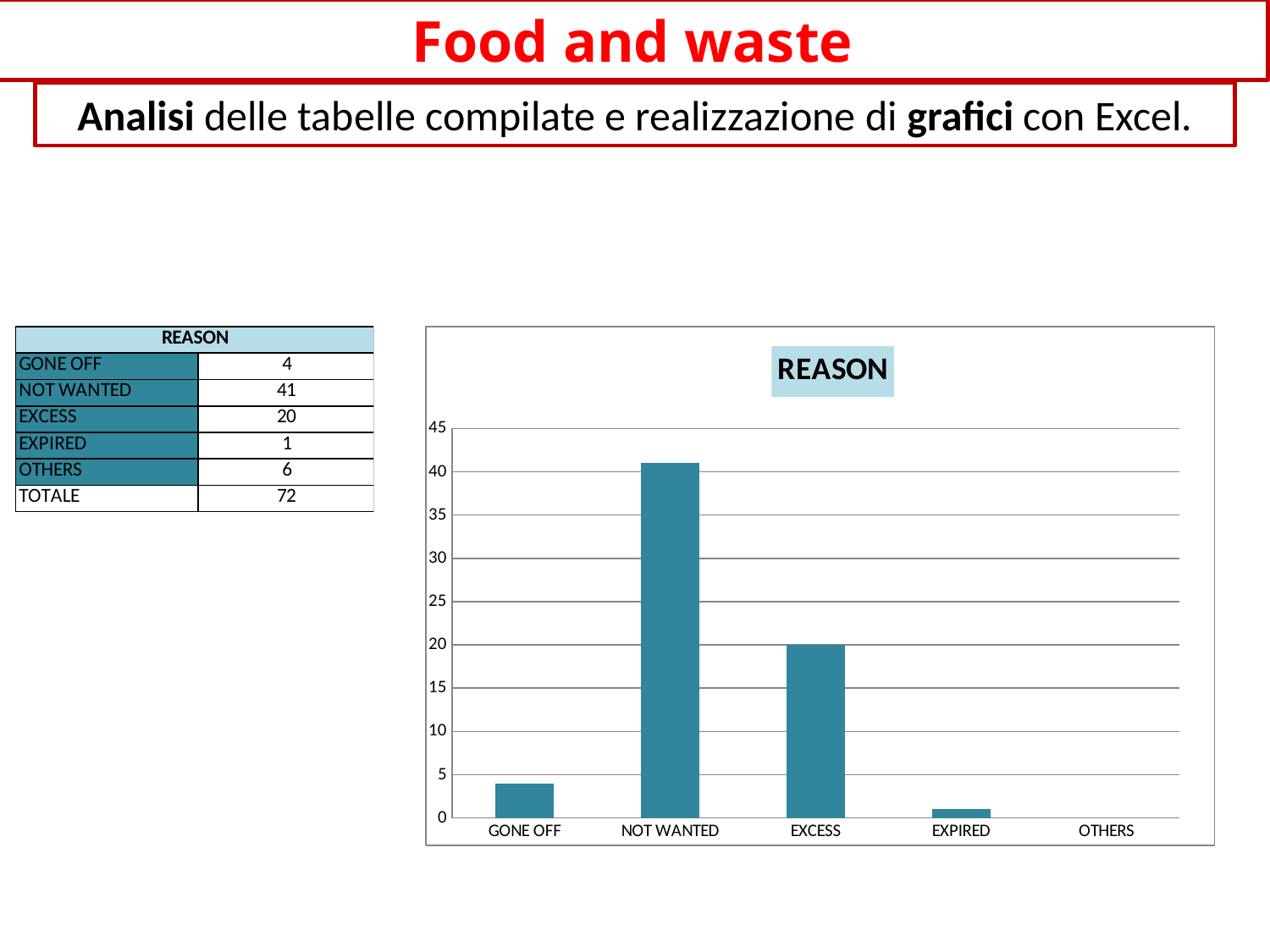
What is the value for EXCESS? 20 Which category has the highest bar in the chart? NOT WANTED What is the difference between the values for NOT WANTED and EXCESS? 21 Which is larger, the value for GONE OFF or the value for EXPIRED? GONE OFF What is the value for NOT WANTED? 41 What kind of chart is shown on the slide? bar chart Is the value for NOT WANTED greater or less than 40? greater Is the value for EXCESS greater or less than 25? less Is the value for GONE OFF greater or less than 5? less What is the value for GONE OFF? 4 What is the title of the chart? REASON How many categories are shown on the x axis of the chart? 5